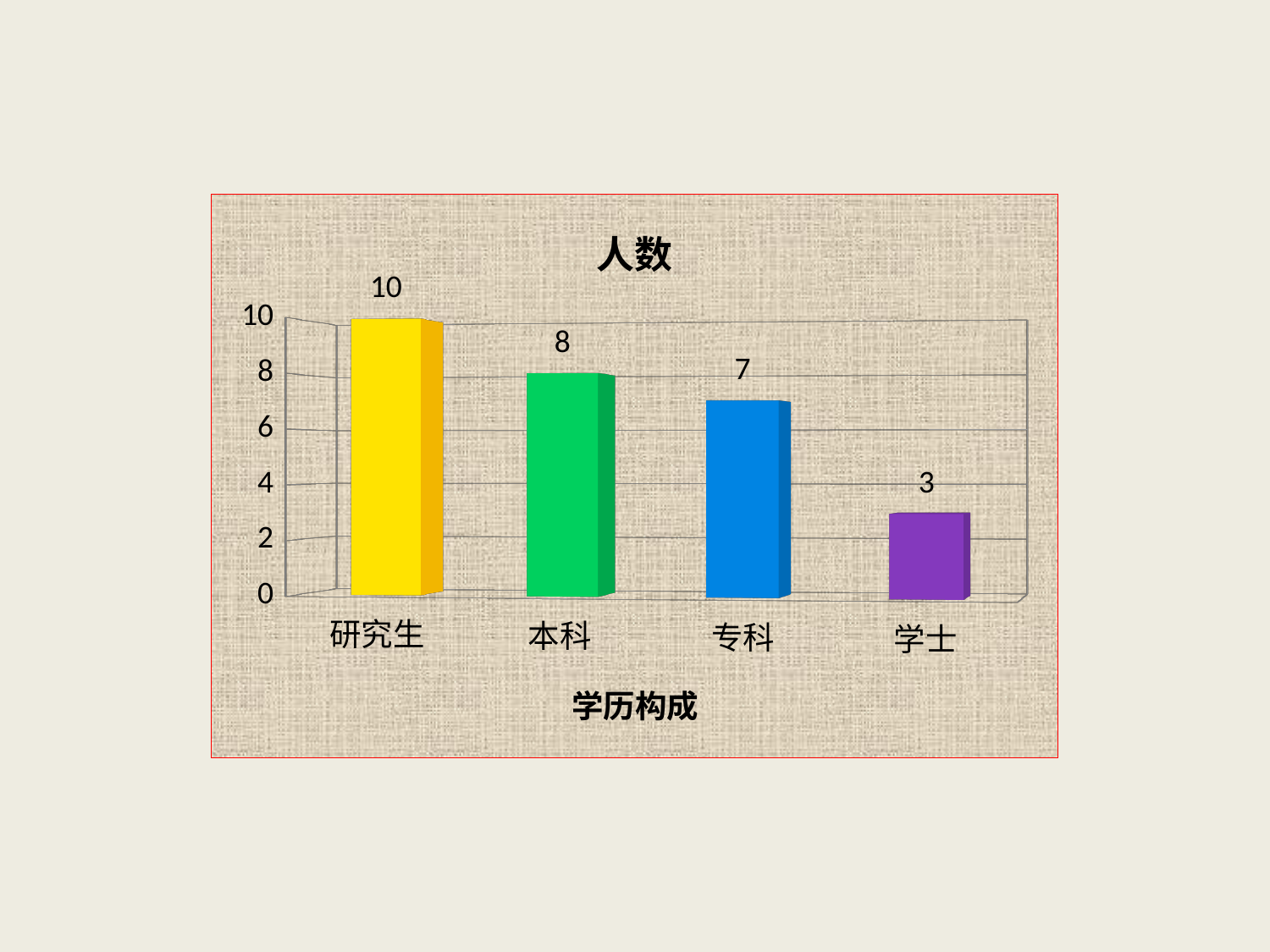
What is the value for 学士? 3 What is the difference between the values for 本科 and 专科? 1 What is the difference between the values for 研究生 and 学士? 7 What is the title of the chart? 人数 What is the value for 研究生? 10 What kind of chart is this? bar chart Which category has the highest value? 研究生 What is the value for 专科? 7 What is the value for 本科? 8 Which category has the lowest value? 学士 Which is larger, the value for 本科 or the value for 学士? 本科 How many categories are shown on the x axis? 4